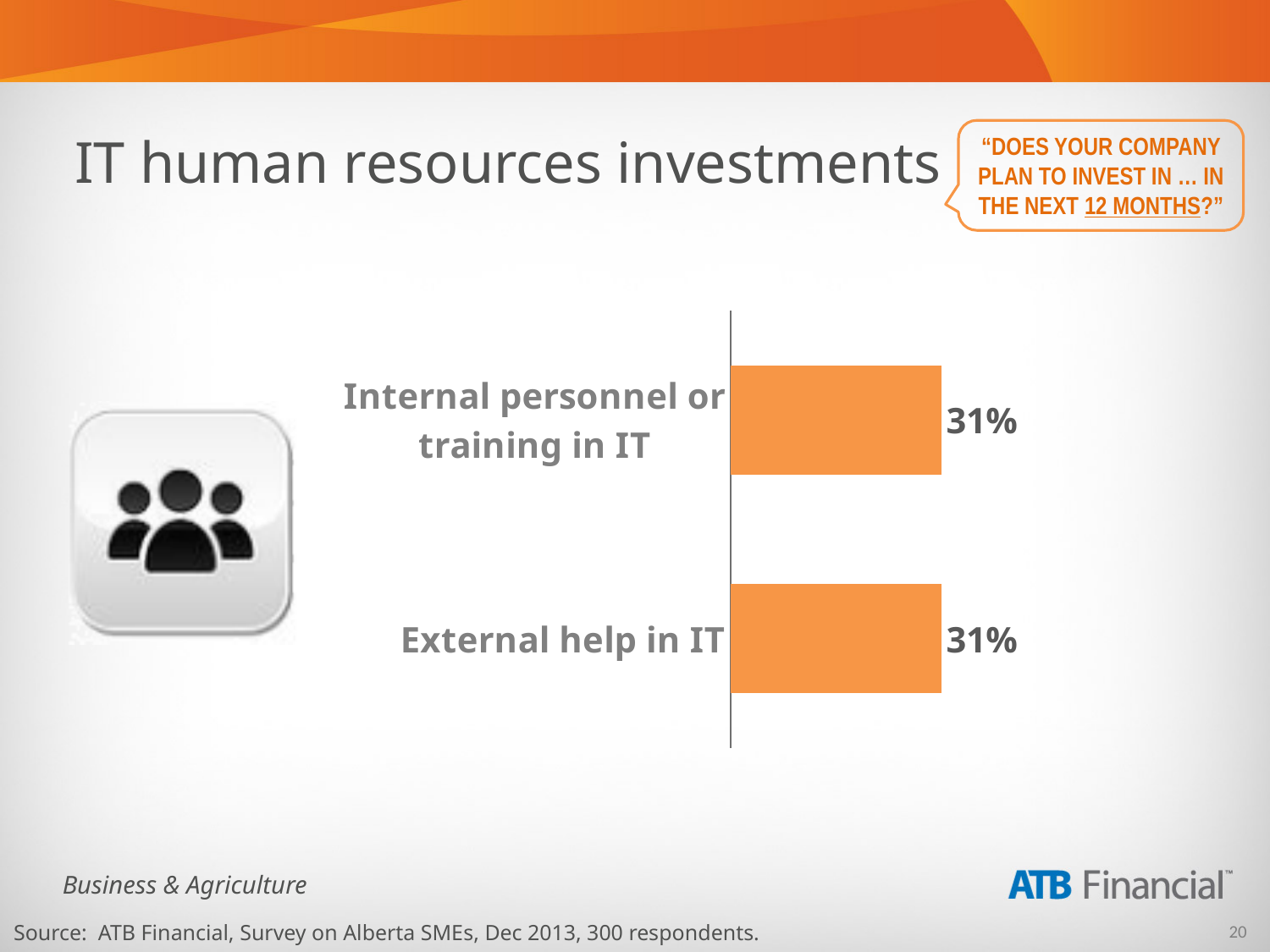
Do the two categories in the chart have the same value? Yes What is the difference between the values for internal personnel or training in IT and external help in IT? 0% How many categories are shown in the chart? 2 What percentage of companies plan to invest in internal personnel or training in IT in the next 12 months? 31% Is the value for external help in IT greater or less than 50%? less Are the bars in the chart horizontal or vertical? Horizontal Is the value for internal personnel or training in IT greater or less than 20%? greater What colour are the bars in the chart? Orange What kind of chart is shown on the slide? Bar chart What percentage of companies plan to invest in external help in IT in the next 12 months? 31%